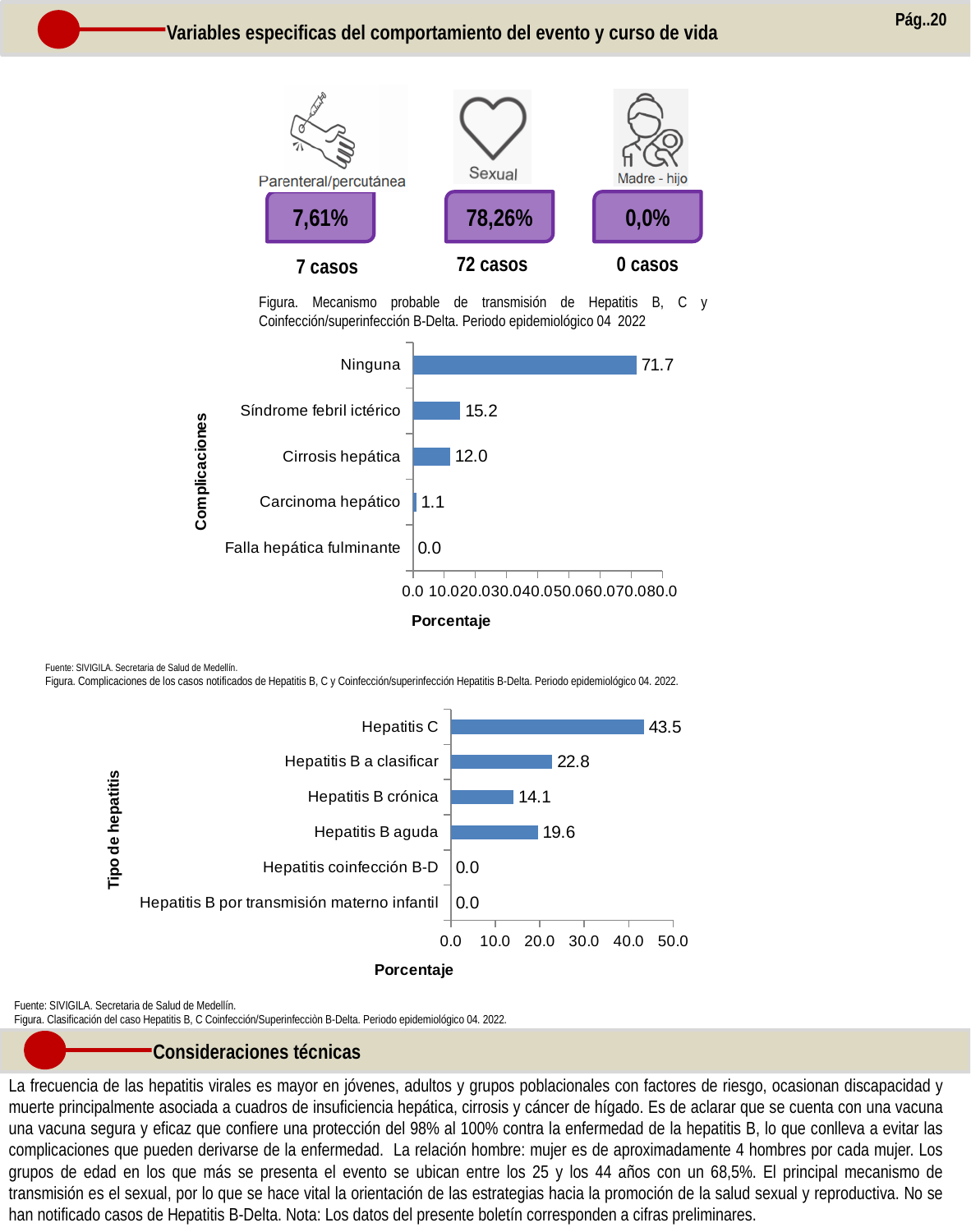
In the lower bar chart (Tipo de hepatitis), how many categories are listed on the y axis? 6 In the upper bar chart (Complicaciones), which complication has the lowest percentage? Falla hepática fulminante In the upper bar chart (Complicaciones), what is the percentage for Cirrosis hepática? 12.0 In the lower bar chart (Tipo de hepatitis), which type of hepatitis has the highest percentage? Hepatitis C What type of chart is the lower chart (Tipo de hepatitis)? Bar chart In the lower bar chart (Tipo de hepatitis), what is the percentage for Hepatitis C? 43.5 In the upper bar chart (Complicaciones), how many complication categories are shown? 5 In the lower bar chart (Tipo de hepatitis), which is larger: Hepatitis B a clasificar or Hepatitis B crónica? Hepatitis B a clasificar In the lower bar chart (Tipo de hepatitis), what is the percentage for Hepatitis B aguda? 19.6 In the upper bar chart (Complicaciones), is the value for Ninguna greater or less than 70.0? greater In the upper bar chart (Complicaciones), what is the difference between Síndrome febril ictérico and Cirrosis hepática? 3.2 In the upper bar chart (Complicaciones), what is the percentage for Ninguna? 71.7